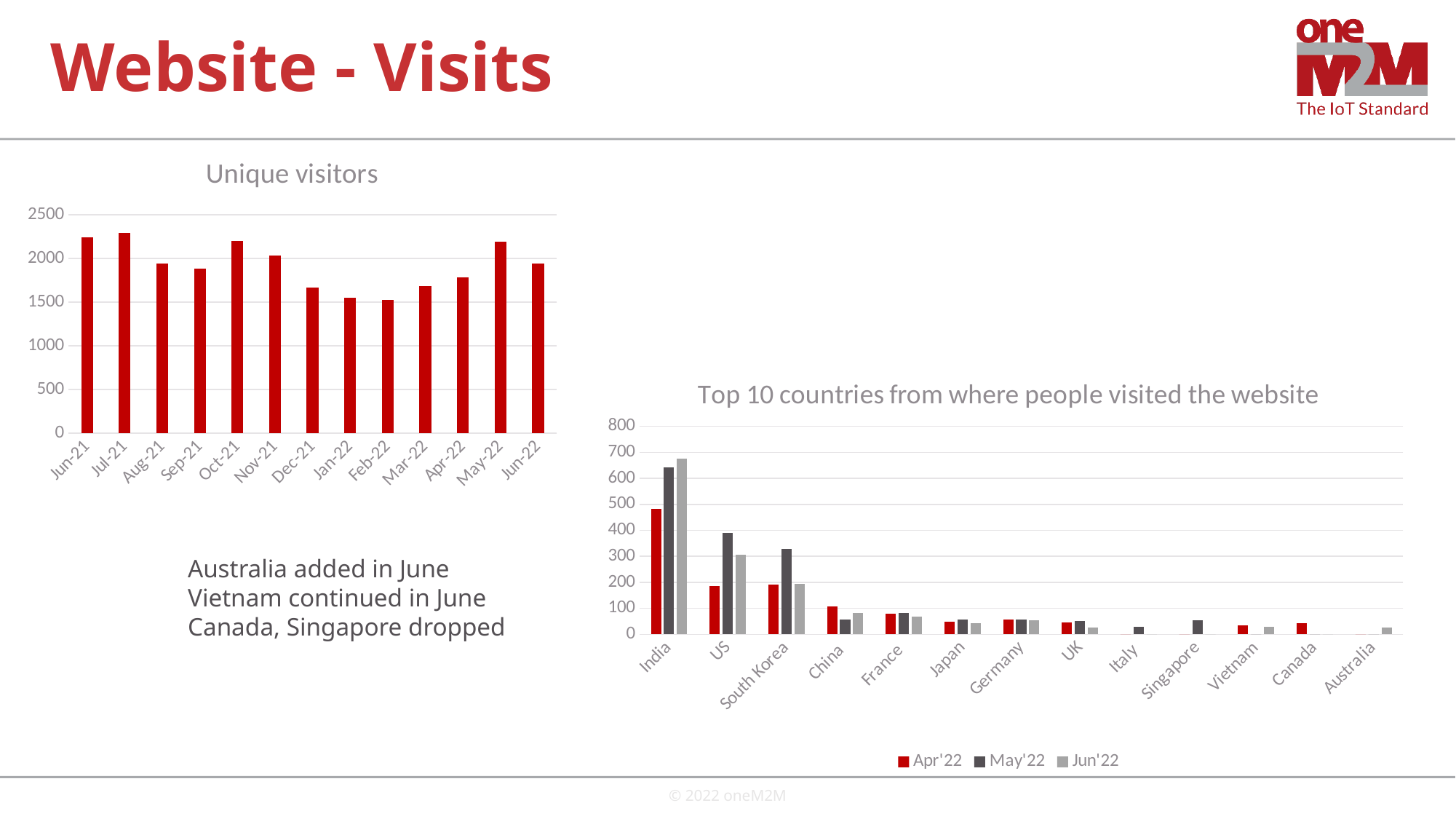
How many countries are shown on the x axis of the "Top 10 countries from where people visited the website" chart? 13 What are the legend entries of the "Top 10 countries from where people visited the website" chart? Apr'22, May'22, Jun'22 In the "Top 10 countries from where people visited the website" chart, is the Jun'22 value for India greater or less than 600? greater In the "Unique visitors" chart, is the value for Apr-22 greater or less than 2000? less What kind of chart is the "Unique visitors" chart? bar chart In the "Unique visitors" chart, is the value for Jun-21 greater or less than 2000? greater In the "Top 10 countries from where people visited the website" chart, which country has the highest Jun'22 value? India In the "Unique visitors" chart, which is larger, the value for Oct-21 or the value for Jan-22? Oct-21 How many series does the legend of the "Top 10 countries from where people visited the website" chart list? 3 How many months are shown on the x axis of the "Unique visitors" chart? 13